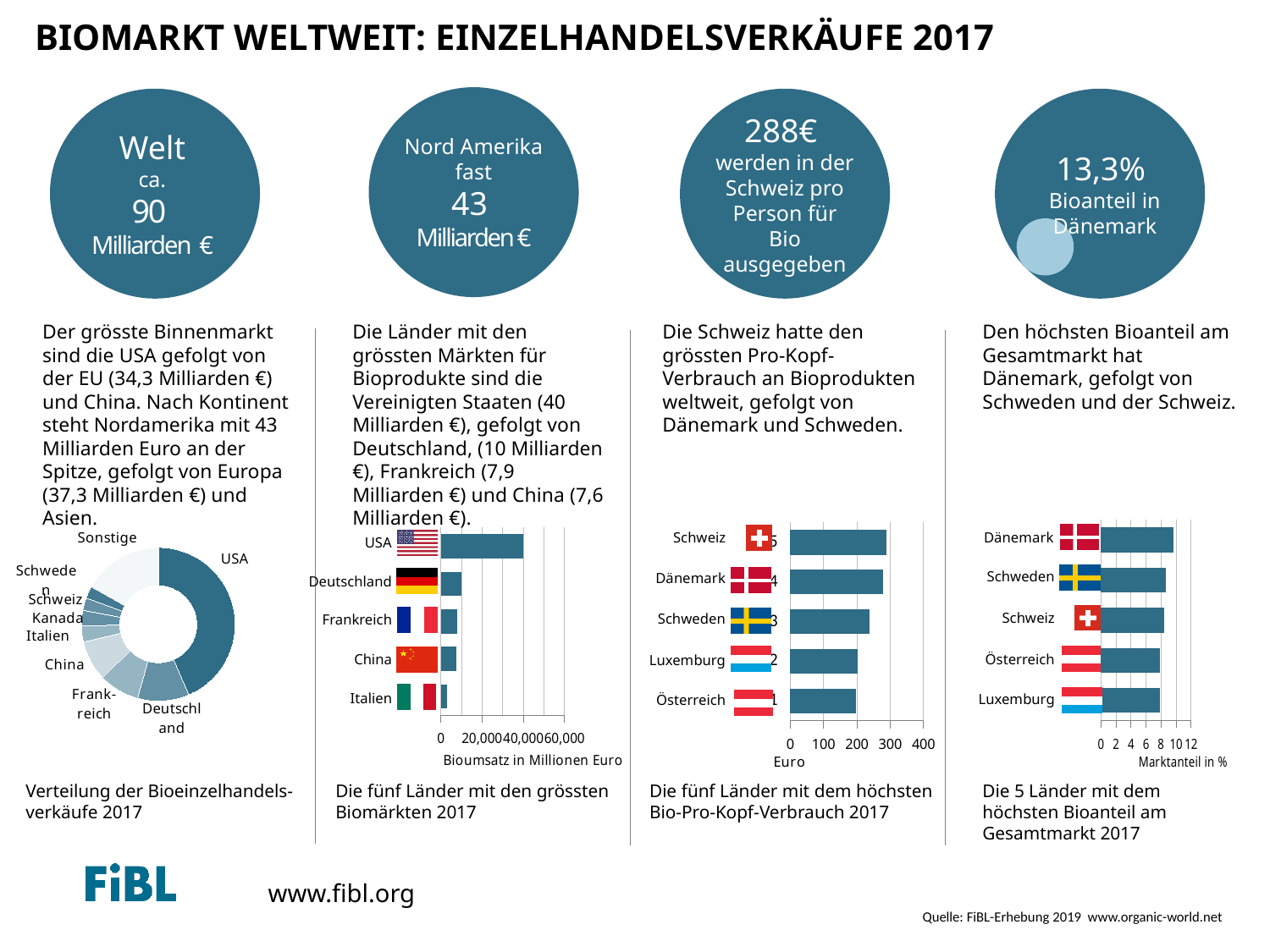
In the chart 'Verteilung der Bioeinzelhandelsverkäufe 2017', which category has the largest slice? USA In the chart 'Die fünf Länder mit dem höchsten Bio-Pro-Kopf-Verbrauch 2017', which country has the highest value? Schweiz In the chart 'Die fünf Länder mit den grössten Biomärkten 2017', which is larger, Deutschland or Frankreich? Deutschland In the chart 'Die fünf Länder mit dem höchsten Bio-Pro-Kopf-Verbrauch 2017', is the value for Schweiz greater or less than 200? greater In the chart 'Die 5 Länder mit dem höchsten Bioanteil am Gesamtmarkt 2017', which country has the highest value? Dänemark In the chart 'Die 5 Länder mit dem höchsten Bioanteil am Gesamtmarkt 2017', is the value for Luxemburg greater or less than 10? less In the chart 'Die fünf Länder mit den grössten Biomärkten 2017', which country has the shortest bar? Italien What is the x-axis title of the chart 'Die fünf Länder mit den grössten Biomärkten 2017'? Bioumsatz in Millionen Euro In the chart 'Die fünf Länder mit den grössten Biomärkten 2017', is the value for USA greater or less than 20,000? greater How many categories are labelled in the chart 'Verteilung der Bioeinzelhandelsverkäufe 2017'? 9 What kind of chart is the one titled 'Verteilung der Bioeinzelhandelsverkäufe 2017'? doughnut chart